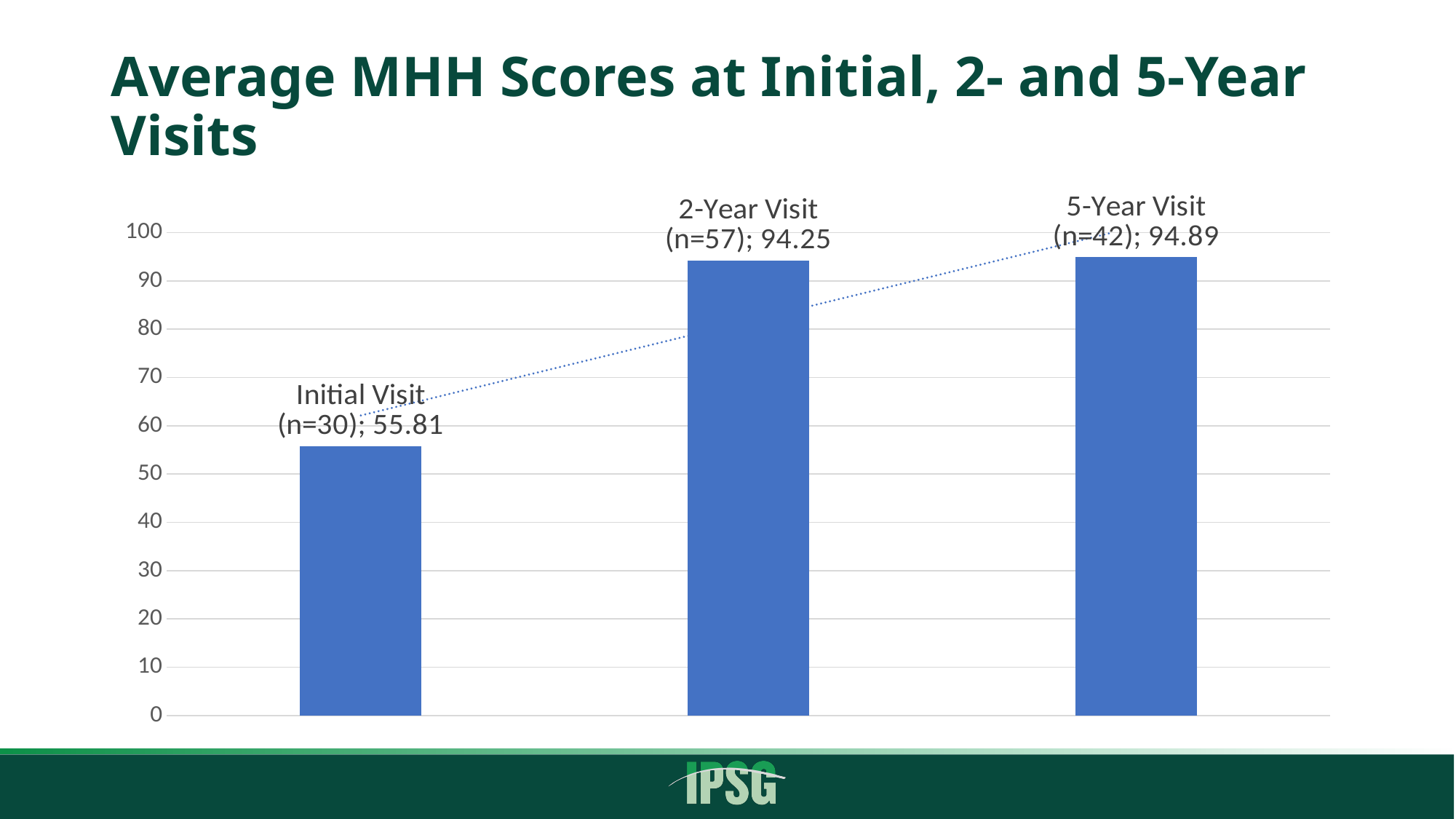
What is the average MHH score at the Initial Visit? 55.81 What is the average MHH score at the 5-Year Visit? 94.89 Do the average MHH scores rise or fall from the Initial Visit to the 5-Year Visit? rise What is the average MHH score at the 2-Year Visit? 94.25 What kind of chart is shown on the slide? bar chart Is the average MHH score at the Initial Visit greater or less than 60? less What is the difference between the average MHH score at the 2-Year Visit and at the Initial Visit? 38.44 Which visit has the highest average MHH score? 5-Year Visit What is the difference between the average MHH score at the 5-Year Visit and at the Initial Visit? 39.08 How many visits are shown as bars in the chart? 3 Which is larger, the average MHH score at the Initial Visit or at the 2-Year Visit? 2-Year Visit Which visit has the lowest average MHH score? Initial Visit